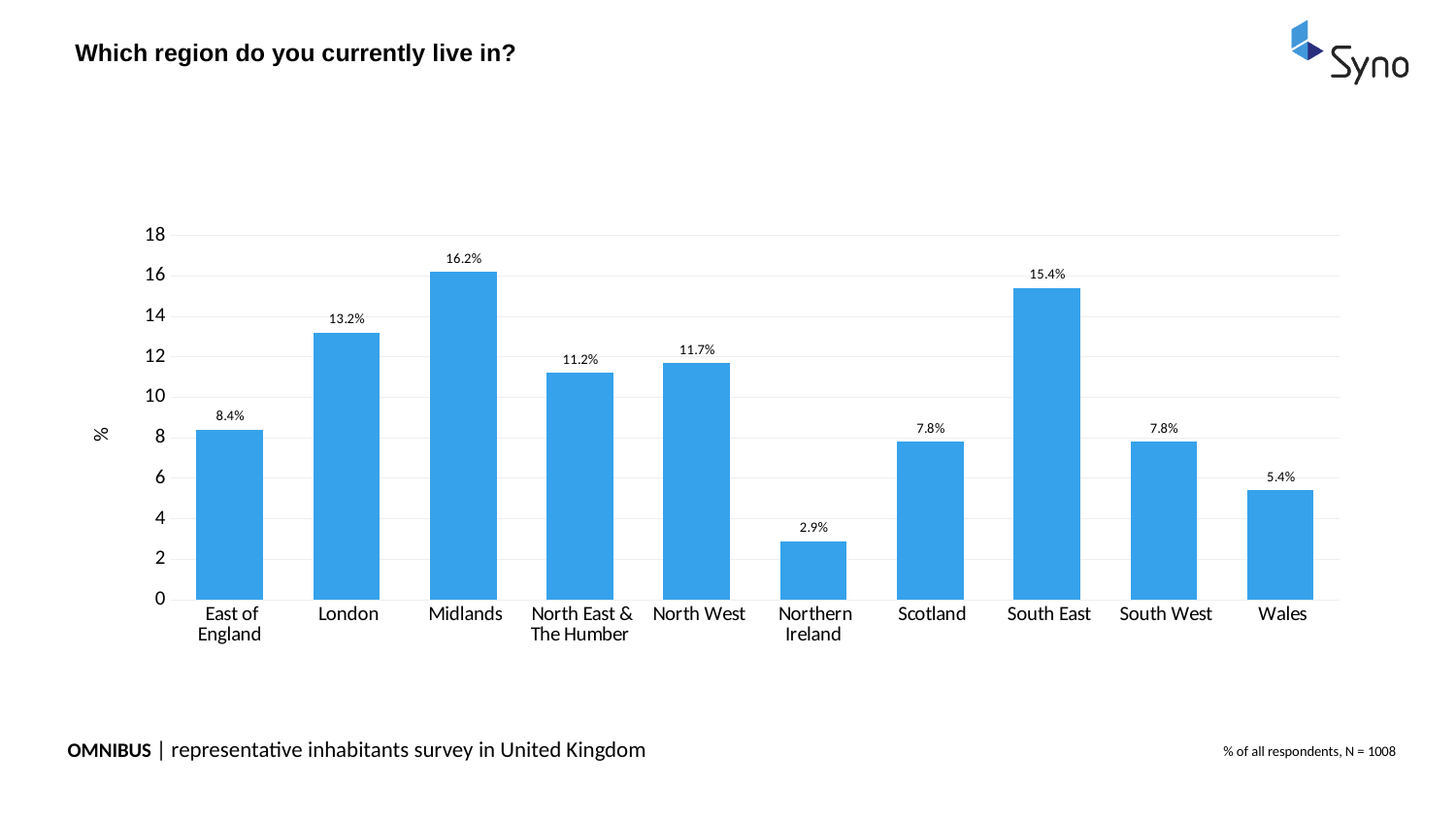
Which region has the lowest percentage of respondents? Northern Ireland What is the value shown for Northern Ireland? 2.9% What is the difference between the values for London and Wales? 7.8% What kind of chart is shown on the slide? Bar chart How many regions are shown on the x axis? 10 What is the difference between the values for Midlands and South East? 0.8% What percentage of respondents live in the South East? 15.4% Which has a larger value, North West or North East & The Humber? North West Which region has the highest percentage of respondents? Midlands What is the title of the chart? Which region do you currently live in? What percentage of respondents live in London? 13.2% Is the value for East of England greater or less than 10? less